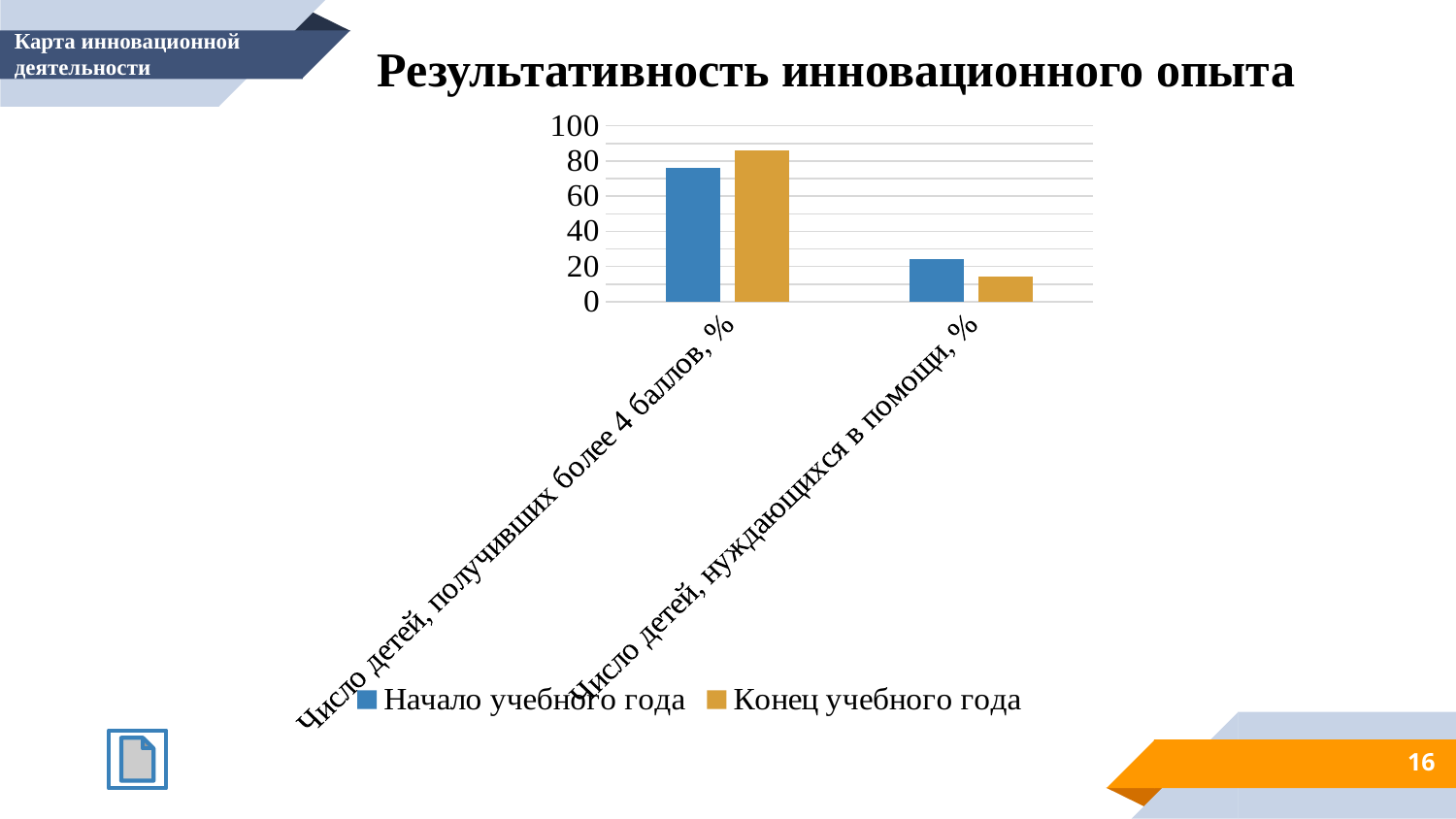
Is the value for "Конец учебного года" in "Число детей, нуждающихся в помощи, %" greater or less than 20? less How many series does the legend list? 2 Is the value for "Начало учебного года" in "Число детей, получивших более 4 баллов, %" greater or less than 80? less How many categories are shown on the x axis? 2 Is the value for "Конец учебного года" in "Число детей, получивших более 4 баллов, %" greater or less than 80? greater For "Число детей, нуждающихся в помощи, %", which is larger: "Начало учебного года" or "Конец учебного года"? Начало учебного года For "Число детей, получивших более 4 баллов, %", which is larger: "Начало учебного года" or "Конец учебного года"? Конец учебного года Which series is shown in orange in the legend? Конец учебного года What is the title of the chart? Результативность инновационного опыта What kind of chart is shown on the slide? bar chart